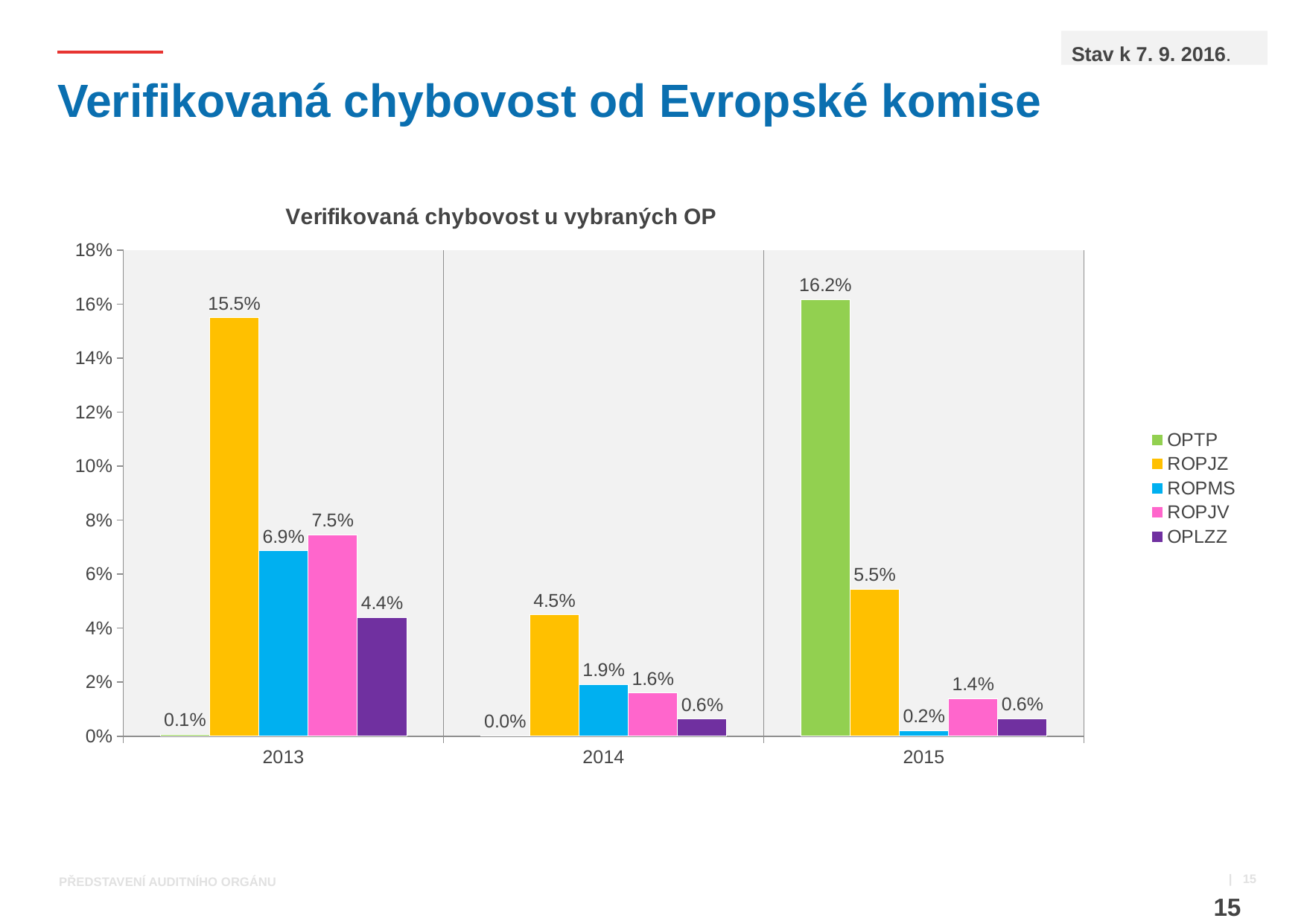
How many series does the legend list? 5 What is the value for OPLZZ in 2013? 4.4% What is the difference between the ROPJZ values in 2013 and 2014? 11.0% Which is larger in 2013, ROPMS or ROPJV? ROPJV What is the value for ROPMS in 2014? 1.9% How many year categories are shown on the x axis? 3 What is the value for OPTP in 2015? 16.2% What kind of chart is shown on the slide? Bar chart Which series has the highest value in 2015? OPTP What is the value for ROPJZ in 2013? 15.5% What is the title of the chart? Verifikovaná chybovost u vybraných OP Which series has the lowest value in 2014? OPTP